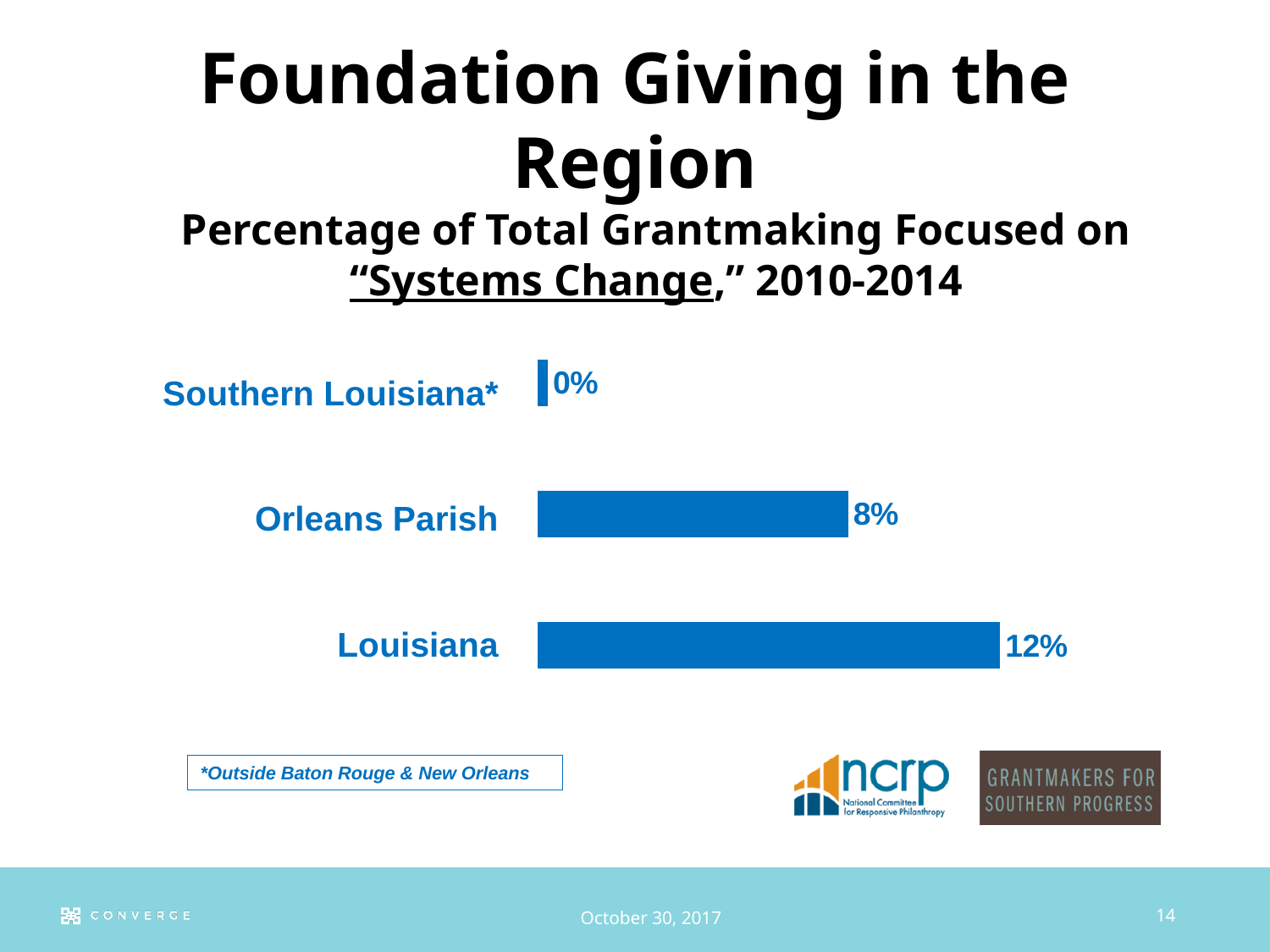
What kind of chart is shown on the slide? bar chart Which category has the lowest value? Southern Louisiana* What is the value for Southern Louisiana*? 0% According to the footnote, what does the asterisk on Southern Louisiana* mean? Outside Baton Rouge & New Orleans How many categories are shown in the chart? 3 What is the value for Orleans Parish? 8% What is the difference between the values for Louisiana and Orleans Parish? 4% What is the value for Louisiana? 12% What is the difference between the values for Orleans Parish and Southern Louisiana*? 8% Which is larger, the value for Orleans Parish or the value for Louisiana? Louisiana Which category has the highest value? Louisiana What time period does the chart subtitle say the data covers? 2010-2014